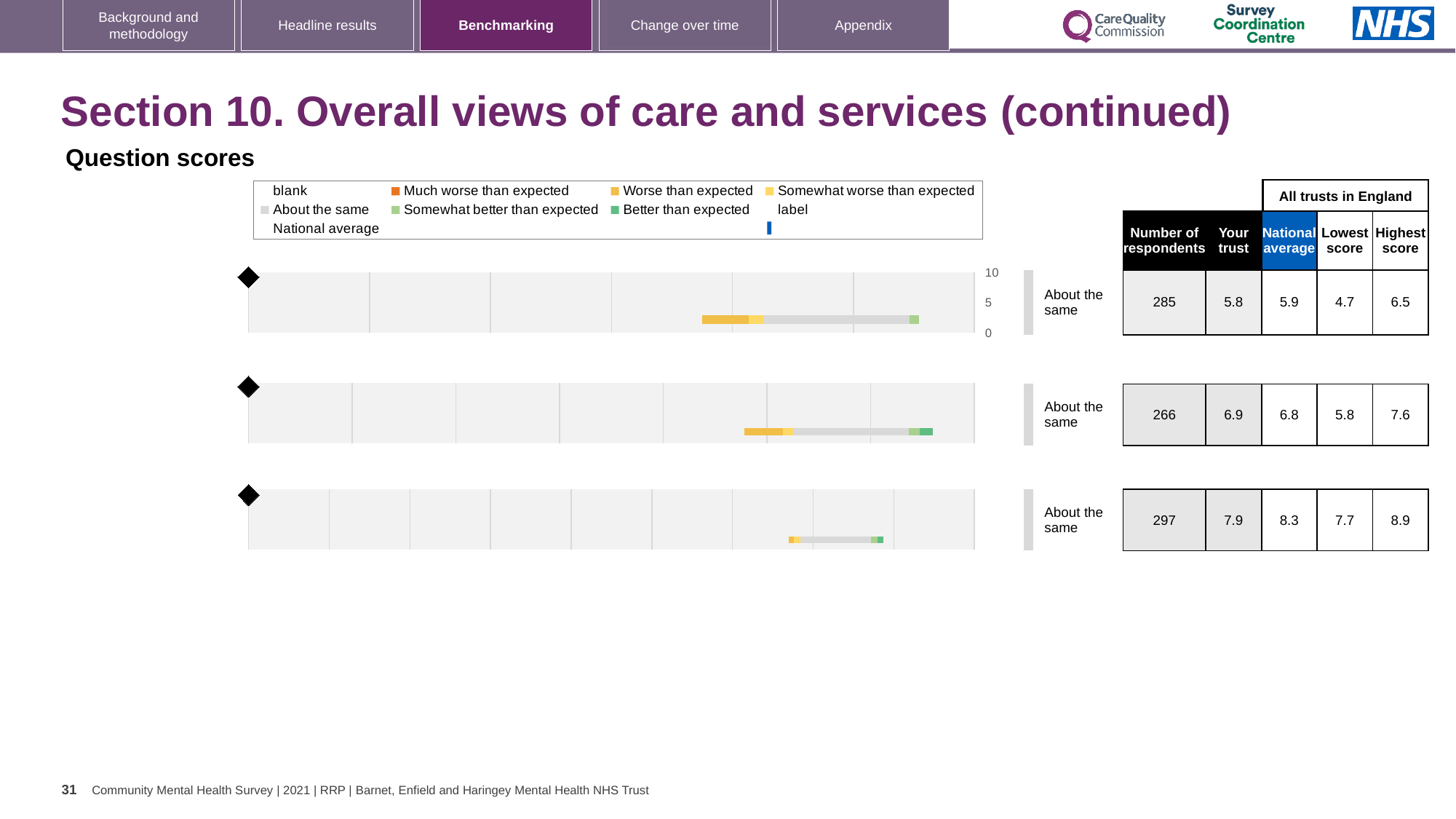
What benchmark category is shown next to the top chart? About the same For the middle chart, which is larger: the 'Your trust' score or the national average? Your trust For the bottom chart, what is the difference between the highest score and the lowest score? 1.2 For the middle chart, how many respondents are there? 266 What kind of chart is used to show the question scores on this slide? bar chart For the top chart, what is the 'Your trust' score? 5.8 Which chart (top, middle or bottom) has the lowest number of respondents? middle For the bottom chart, which is larger: the 'Your trust' score or the national average? National average For the top chart, what is the national average score? 5.9 How many question score charts are shown on the slide? 3 Which chart (top, middle or bottom) has the highest 'Your trust' score? bottom For the bottom chart, what is the highest score among all trusts in England? 8.9